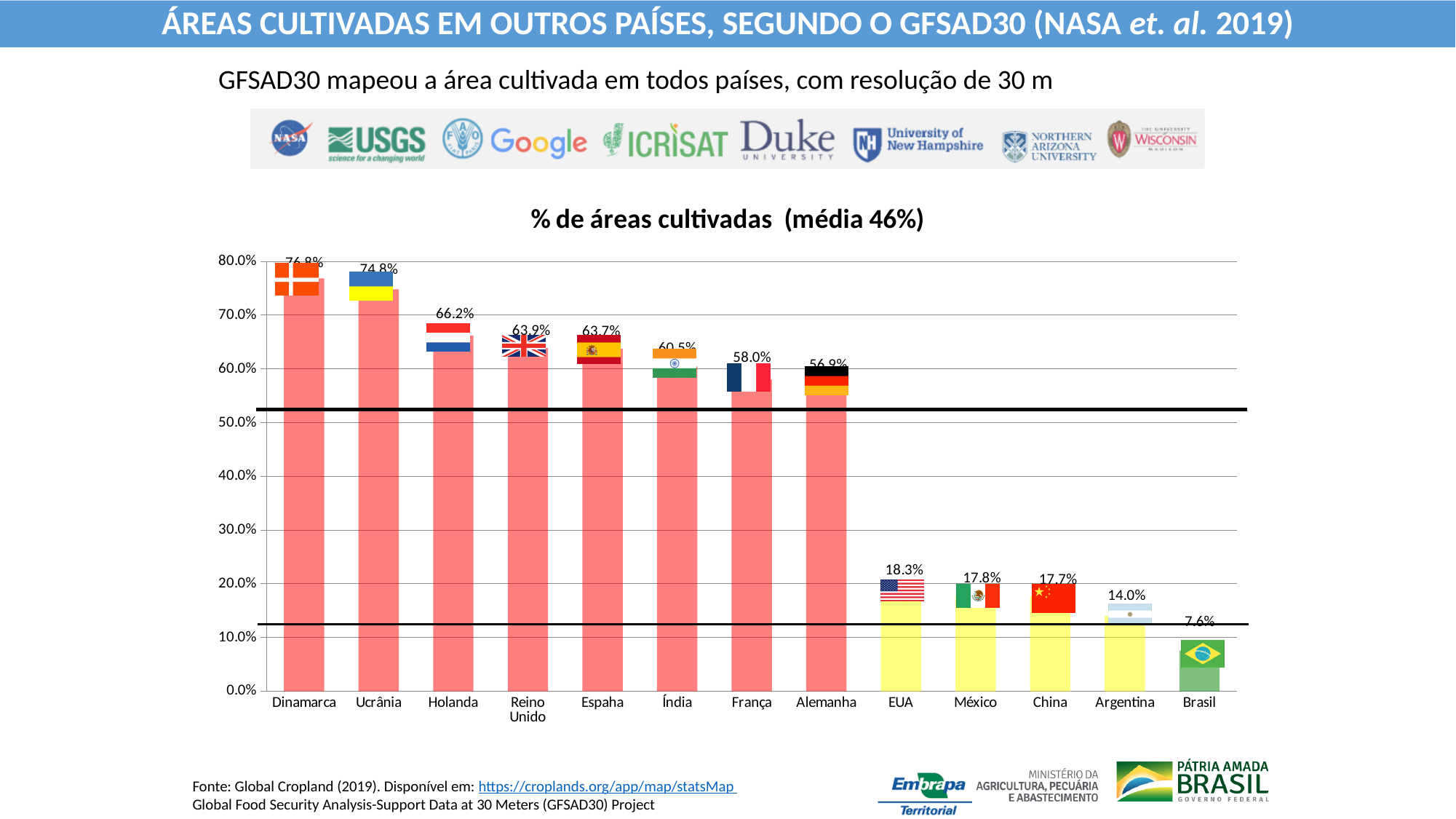
Do the values rise or fall from left to right along the x axis? Fall What type of chart is shown on the slide? Bar chart What is the difference between the values for EUA and México? 0.5% Which has a larger value, Holanda or França? Holanda How many countries are shown in the chart? 13 Which country has the highest percentage of cultivated area in the chart? Dinamarca What is the value for EUA in the chart? 18.3% Which country has the lowest percentage of cultivated area in the chart? Brasil Is the value for Brasil greater or less than 10.0%? less What is the value for França in the chart? 58.0% What is the value for Argentina in the chart? 14.0% What is the value for Holanda in the chart? 66.2%